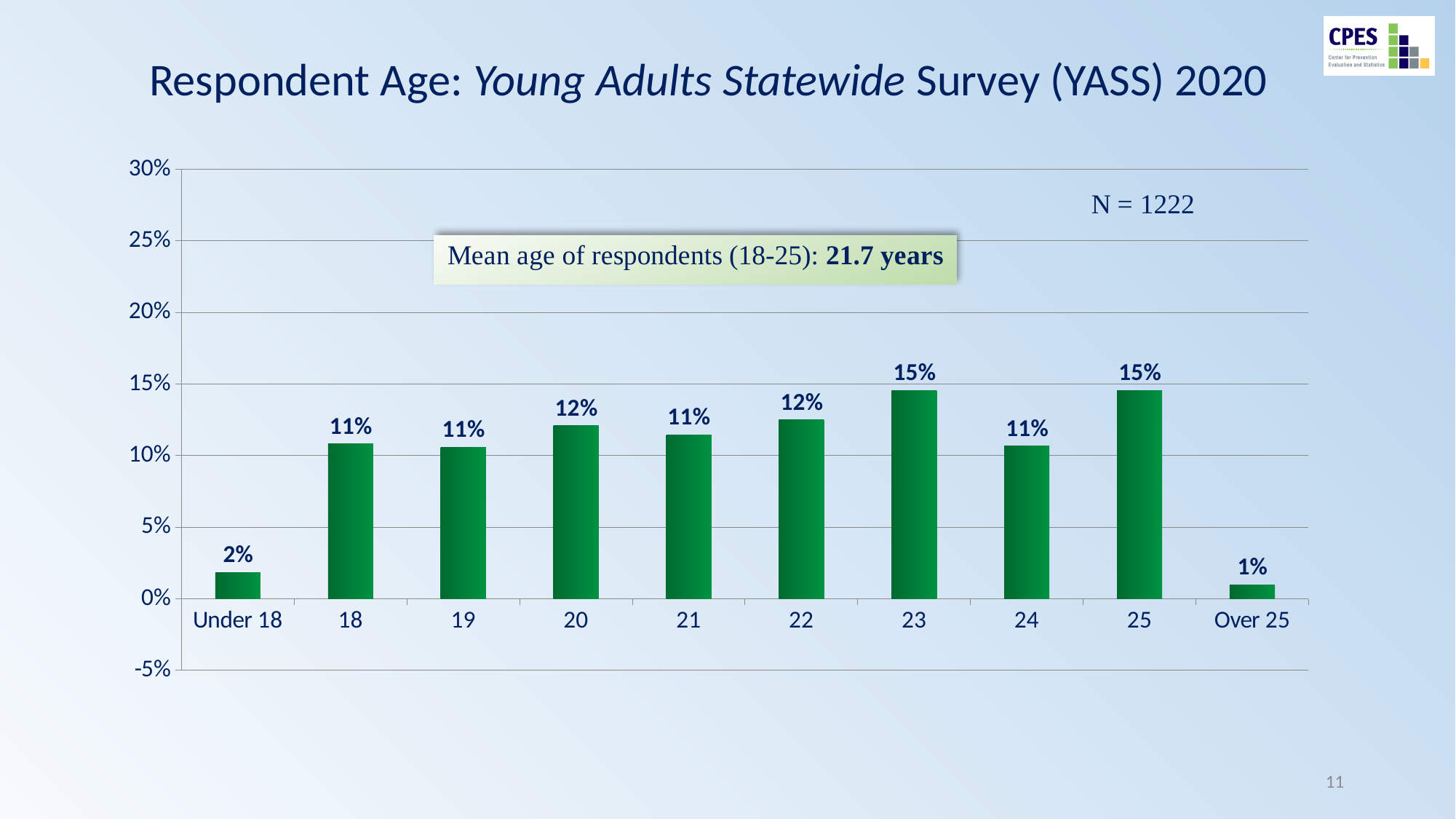
What percentage of respondents were Under 18? 2% What is the mean age of respondents (18-25) stated on the slide? 21.7 years Which has a larger share of respondents, age 23 or age 20? 23 What is the difference in percentage points between age 23 and Under 18? 13 percentage points What is the sample size (N) shown on the chart? 1222 Is the value for age 22 greater or less than 10%? greater What kind of chart is shown on the slide? bar chart Which two age categories share the highest percentage of respondents? 23 and 25 Which age category has the lowest percentage of respondents? Over 25 What percentage of respondents were age 23? 15% How many age categories are shown on the x axis? 10 What is the value shown for age 20? 12%